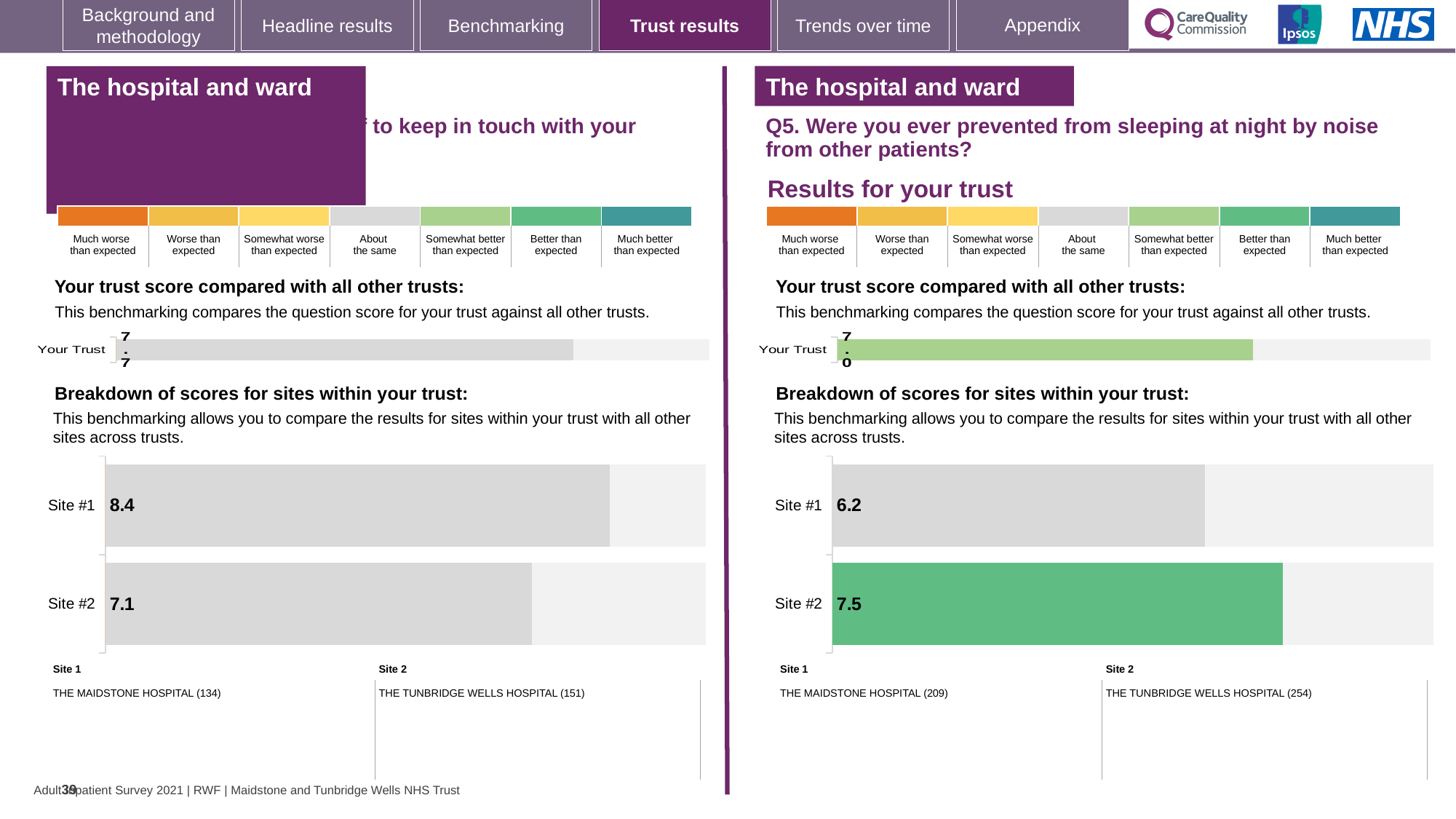
On the left-hand side of the slide, is the Site #1 score larger or smaller than the Site #2 score? larger On the left-hand side of the slide, what is the score for Site #1 in the breakdown of scores for sites? 8.4 On the right-hand side of the slide (Q5), what is the score for Site #2 in the breakdown of scores for sites? 7.5 On the right-hand side of the slide (Q5), which site has the higher score in the breakdown of scores for sites? Site #2 How many sites are shown in the breakdown of scores chart on the right-hand side of the slide (Q5)? 2 On the left-hand side of the slide, which site has the lower score in the breakdown of scores for sites? Site #2 On the left-hand side of the slide, what is the score for Site #2 in the breakdown of scores for sites? 7.1 On the right-hand side of the slide (Q5), what colour is the Site #2 bar in the breakdown of scores for sites? green On the right-hand side of the slide (Q5, prevented from sleeping by noise from other patients), what is the score for Site #1 in the breakdown of scores for sites? 6.2 On the right-hand side of the slide (Q5), what is the difference between the Site #2 score and the Site #1 score? 1.3 On the left-hand side of the slide, what is the difference between the Site #1 score and the Site #2 score? 1.3 What kind of chart is used for the breakdown of scores for sites on the right-hand side of the slide (Q5)? bar chart